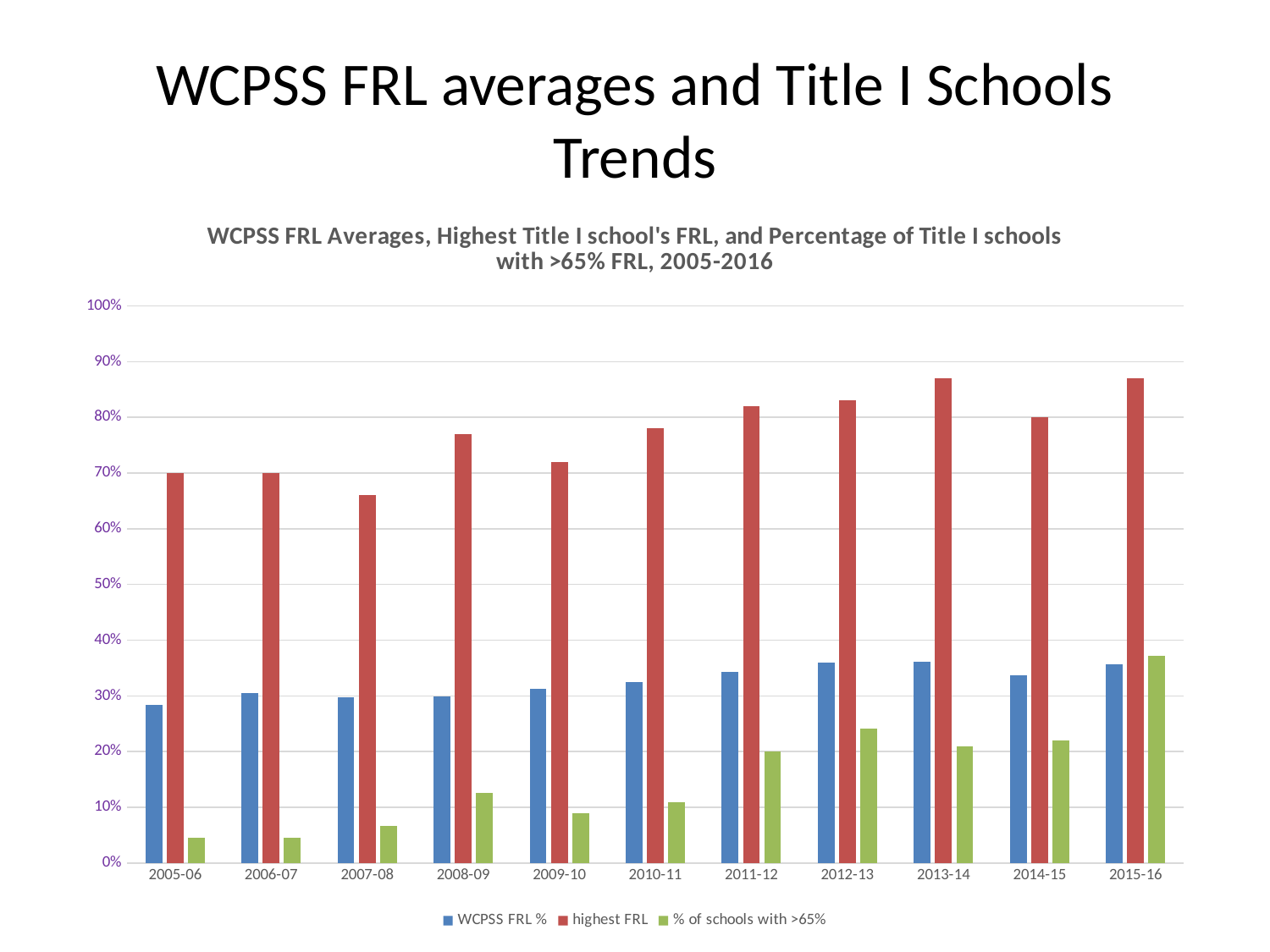
How many school years are shown on the x axis? 11 Is the 'WCPSS FRL %' value for 2005-06 greater or less than 30%? less What kind of chart is shown on the slide? bar chart What colour represents the 'highest FRL' series in the legend? red Which is larger: the '% of schools with >65%' value for 2012-13 or for 2011-12? 2012-13 Which school year has the lowest value for the 'highest FRL' series? 2007-08 Is the '% of schools with >65%' value for 2008-09 greater or less than 10%? greater Is the 'highest FRL' value for 2008-09 greater or less than 70%? greater How many series does the legend list? 3 Which school year has the highest value for the '% of schools with >65%' series? 2015-16 Does the '% of schools with >65%' series generally rise or fall from 2005-06 to 2015-16? rise